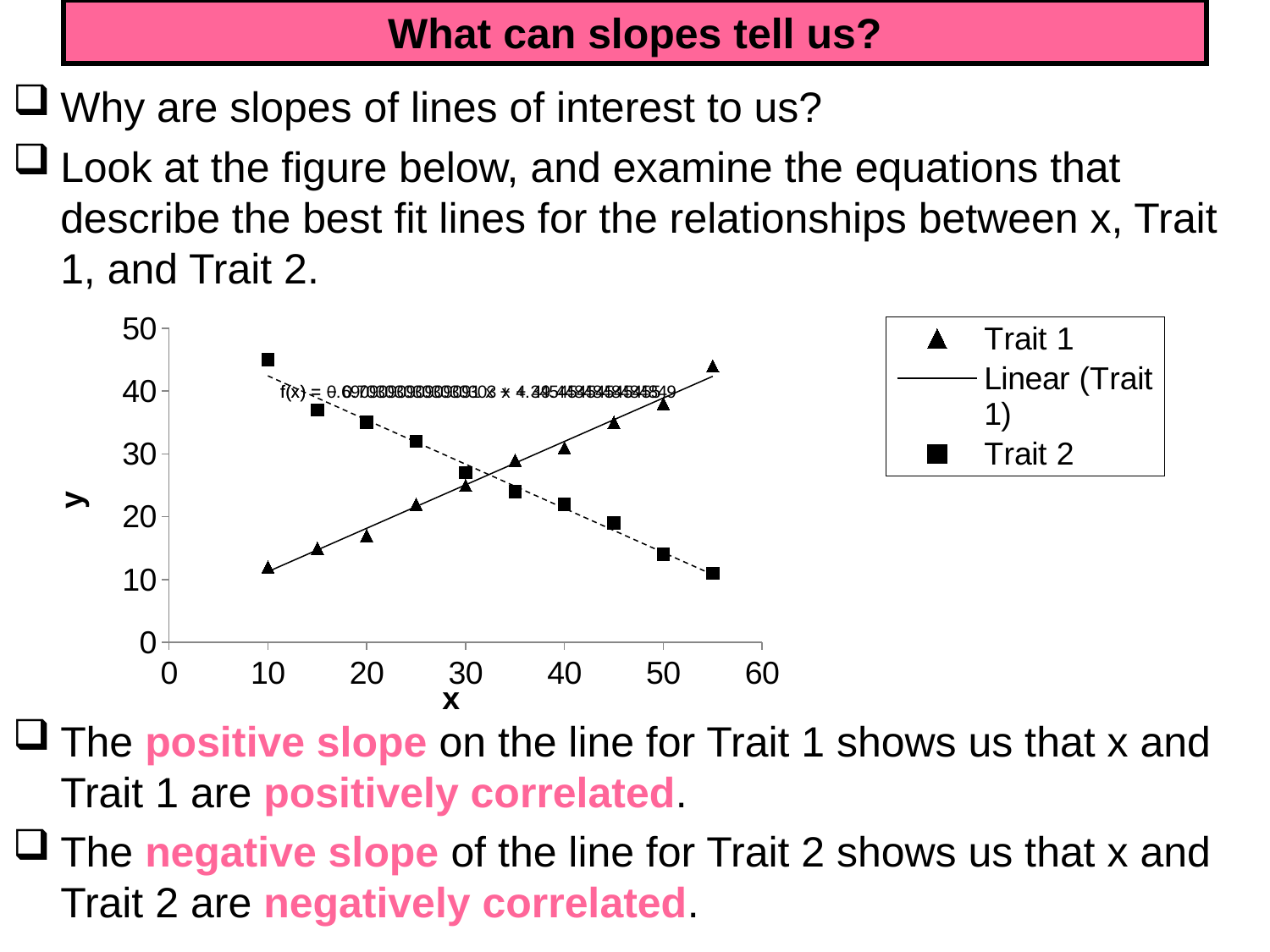
Do the Trait 2 values rise or fall as x increases? Fall Do the Trait 1 values rise or fall as x increases? Rise What is the label on the vertical axis of the chart? y How many data points are plotted for Trait 1? 10 Is the Trait 1 value at x = 10 greater or less than 20? less At x = 55, which series has the larger value, Trait 1 or Trait 2? Trait 1 How many entries does the chart legend list? 3 Is the Trait 2 value at x = 55 greater or less than 20? less At x = 10, which series has the larger value, Trait 1 or Trait 2? Trait 2 At which x value does Trait 2 reach its highest value? 10 Is the Trait 2 value at x = 10 greater or less than 40? greater What kind of chart is shown on the slide? Scatter plot